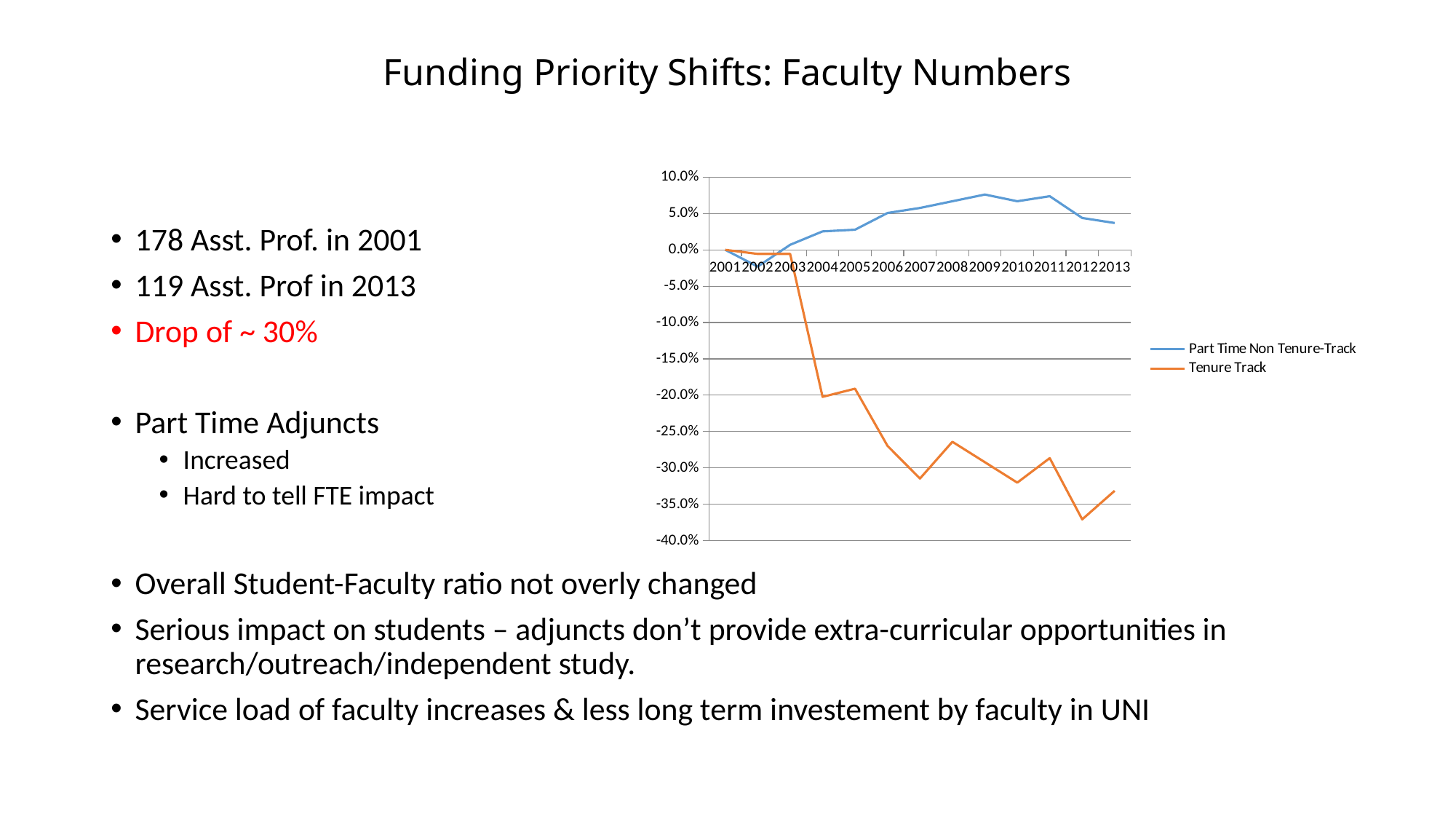
How many years are plotted along the x axis of the chart? 13 Is the Part Time Non Tenure-Track value for 2009 greater or less than 5.0%? greater How many series does the chart's legend list? 2 What kind of chart is shown on the slide? line chart What is the first year shown on the chart's x axis? 2001 Is the Tenure Track value for 2012 greater or less than -35.0%? less In 2013, which series has the higher value, Part Time Non Tenure-Track or Tenure Track? Part Time Non Tenure-Track Which series is drawn in orange in the chart? Tenure Track Does the Tenure Track series generally rise or fall from 2001 to 2013? fall Is the Tenure Track value for 2004 greater or less than -15.0%? less In which year does the Tenure Track series reach its lowest value? 2012 Does the Part Time Non Tenure-Track series generally rise or fall from 2001 to 2009? rise